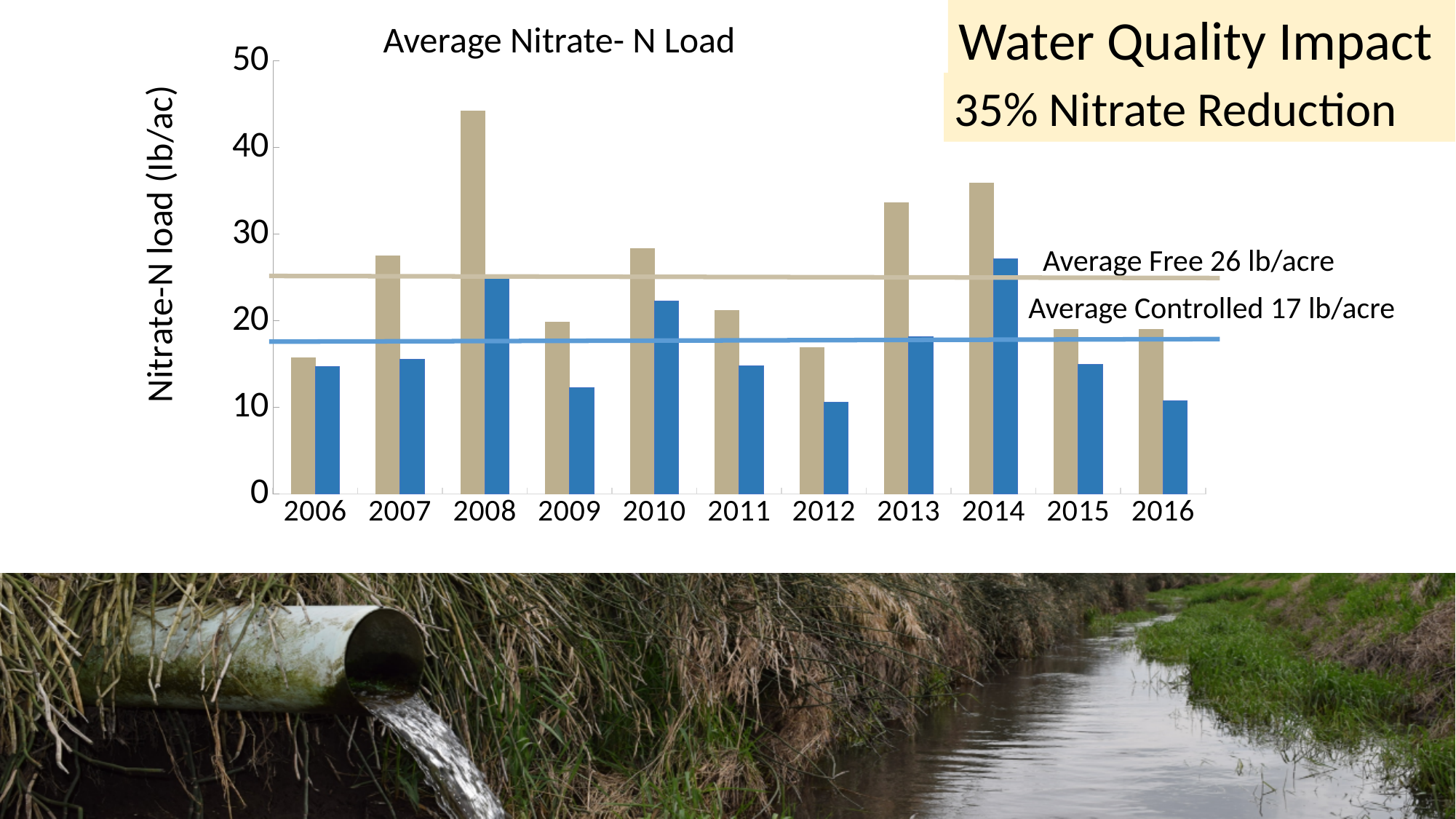
Which is larger, the blue (Controlled) bar for 2014 or the blue (Controlled) bar for 2012? 2014 What kind of chart is shown on the slide? bar chart Is the blue (Controlled) bar for 2012 greater or less than 20? less What is the average nitrate-N load for the Free treatment, as labelled on the chart? 26 lb/acre What is the title of the chart? Average Nitrate- N Load In which year is the tan (Free) bar the highest? 2008 Is the tan (Free) bar for 2013 greater or less than 30? greater What is the difference between the Average Free and Average Controlled values labelled on the chart? 9 lb/acre Is the tan (Free) bar for 2008 greater or less than 40? greater How many years are shown on the x axis of the chart? 11 What is the average nitrate-N load for the Controlled treatment, as labelled on the chart? 17 lb/acre In which year is the blue (Controlled) bar the highest? 2014